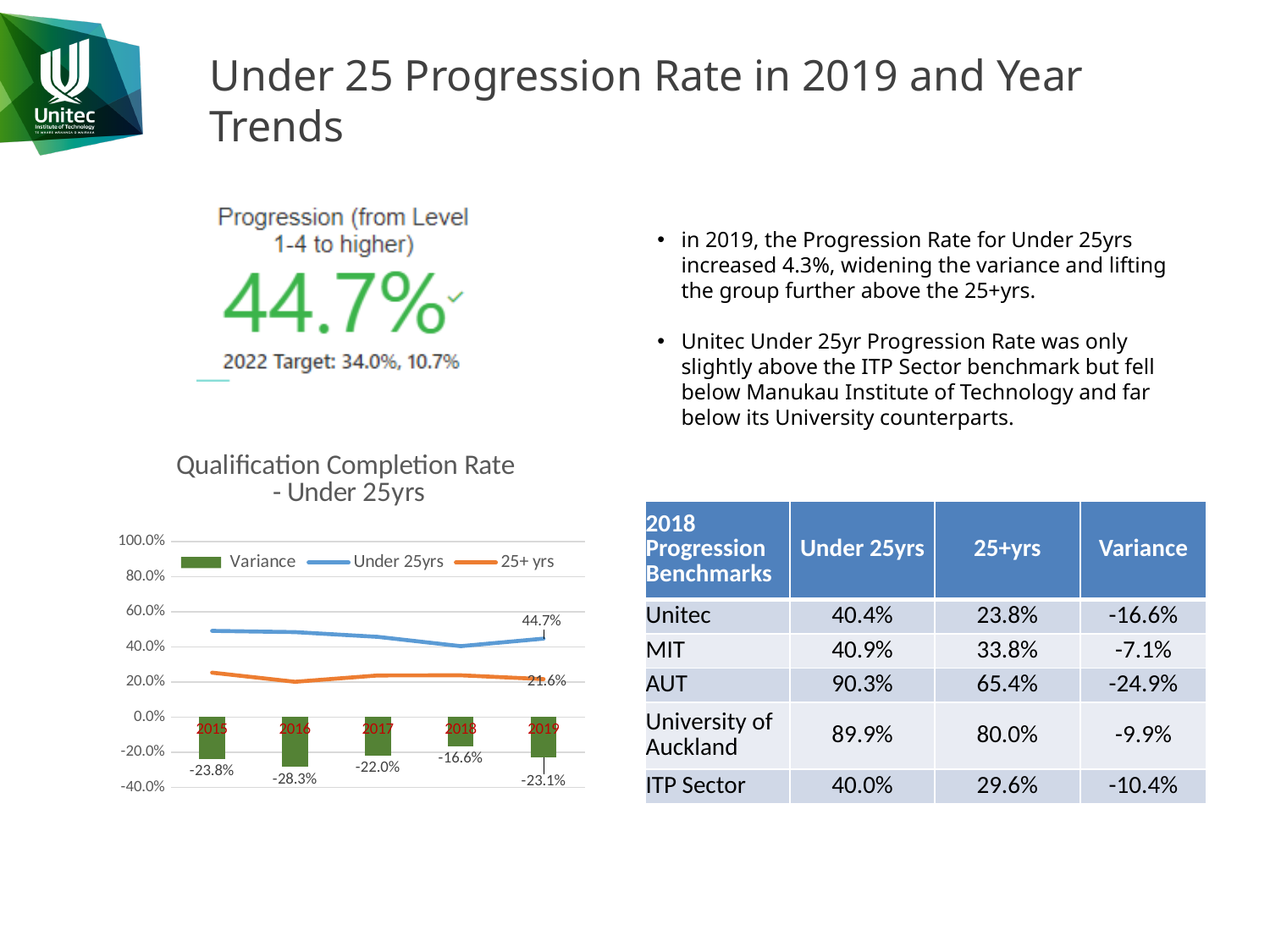
Which year has the highest (least negative) Variance in the chart? 2018 What is the 25+ yrs value for 2019 in the chart? 21.6% Is the Under 25yrs value for 2015 greater or less than 40.0%? greater Which year has the lowest (most negative) Variance in the chart? 2016 In 2018, which is larger: the Under 25yrs value or the 25+ yrs value? Under 25yrs How is the Variance series plotted in the chart, as bars or as a line? As bars How many years are shown on the x axis of the chart? 5 What is the Under 25yrs value for 2019 in the chart? 44.7% How many series does the chart's legend list? 3 Does the Under 25yrs line rise or fall from 2015 to 2018? Fall What is the Variance value for 2016 in the Qualification Completion Rate - Under 25yrs chart? -28.3% In 2019, how much higher is the Under 25yrs value than the 25+ yrs value? 23.1%